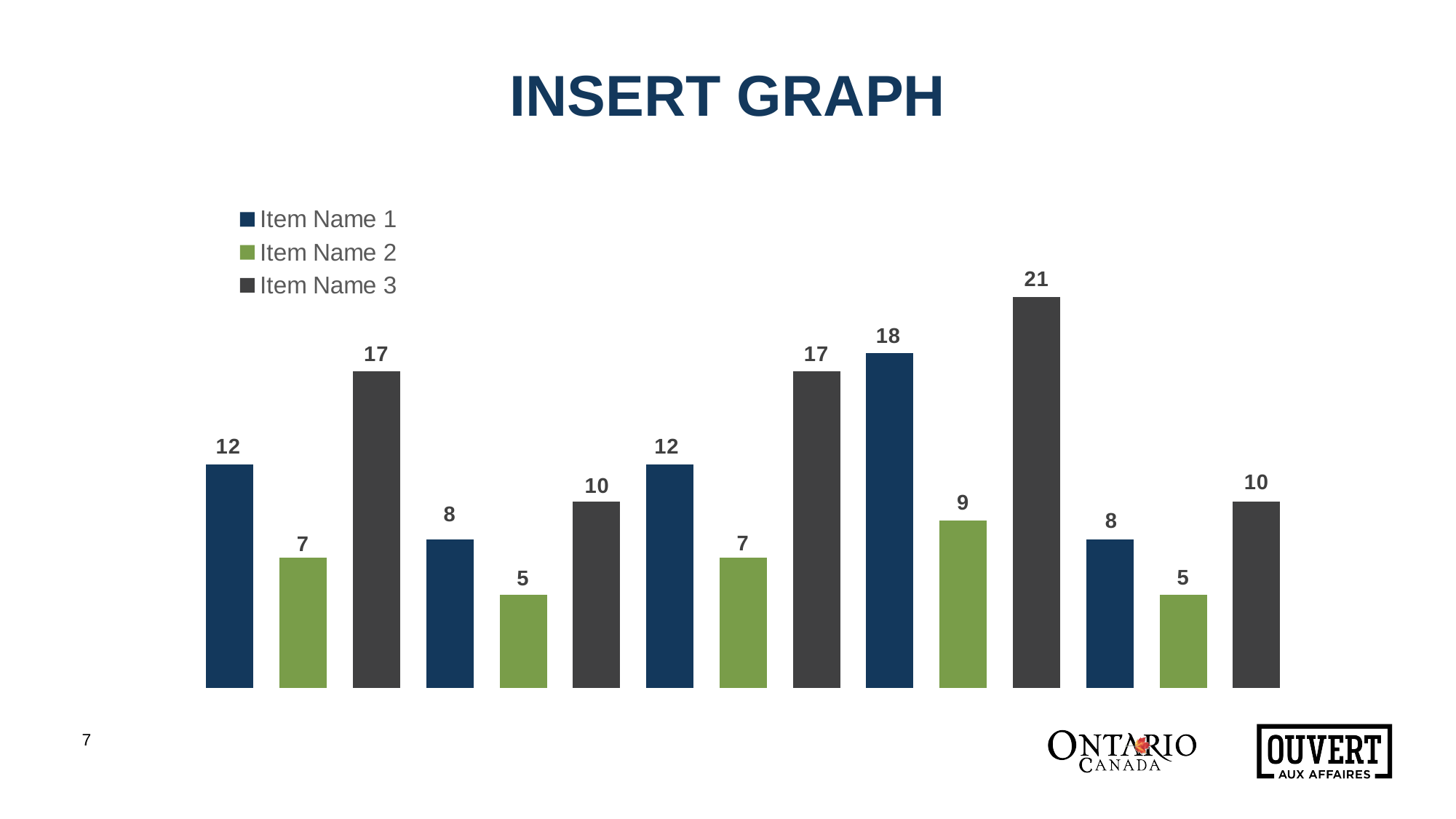
What is the title shown above the chart? INSERT GRAPH In the first group of bars from the left, which is larger: Item Name 1 or Item Name 2? Item Name 1 In the fourth group of bars from the left, what is the difference between Item Name 3 and Item Name 1? 3 What kind of chart is shown on the slide? bar chart How many groups of bars are plotted along the x axis? 5 What is the lowest value shown for Item Name 2? 5 What is the value of Item Name 1 in the fourth group of bars from the left? 18 What colour are the bars for Item Name 2? green What is the highest value shown on the chart? 21 How many series does the legend list? 3 What is the total of the three values in the first group of bars from the left? 36 What is the value of Item Name 3 in the second group of bars from the left? 10